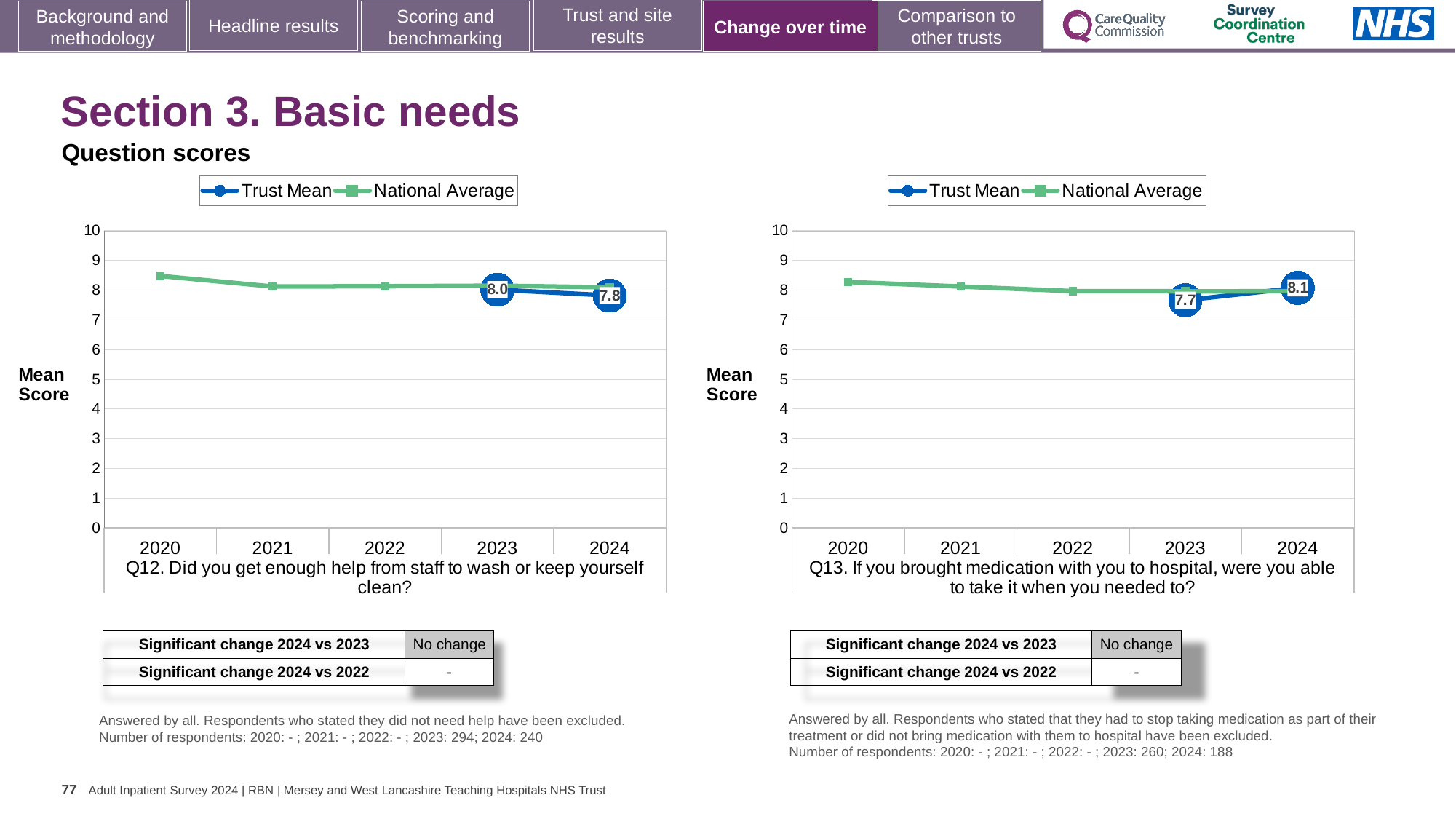
In the Q12 chart (left), what is the Trust Mean value for 2024? 7.8 In the Q13 chart (right), what is the Trust Mean value for 2024? 8.1 How many years are shown on the x axis of the Q12 chart (left)? 5 What type of chart is the Q13 chart (right)? line chart In the Q12 chart (left), is the National Average value for 2020 greater or less than 8? greater In the Q12 chart (left), what is the Trust Mean value for 2023? 8.0 In the Q12 chart (left), by how much did the Trust Mean change from 2023 to 2024? 0.2 In the Q12 chart (left), does the Trust Mean rise or fall from 2023 to 2024? fall In the Q13 chart (right), which year has the higher Trust Mean, 2023 or 2024? 2024 In the Q13 chart (right), what is the difference between the Trust Mean in 2024 and in 2023? 0.4 In the Q13 chart (right), what is the Trust Mean value for 2023? 7.7 How many series does the legend of the Q13 chart (right) list? 2